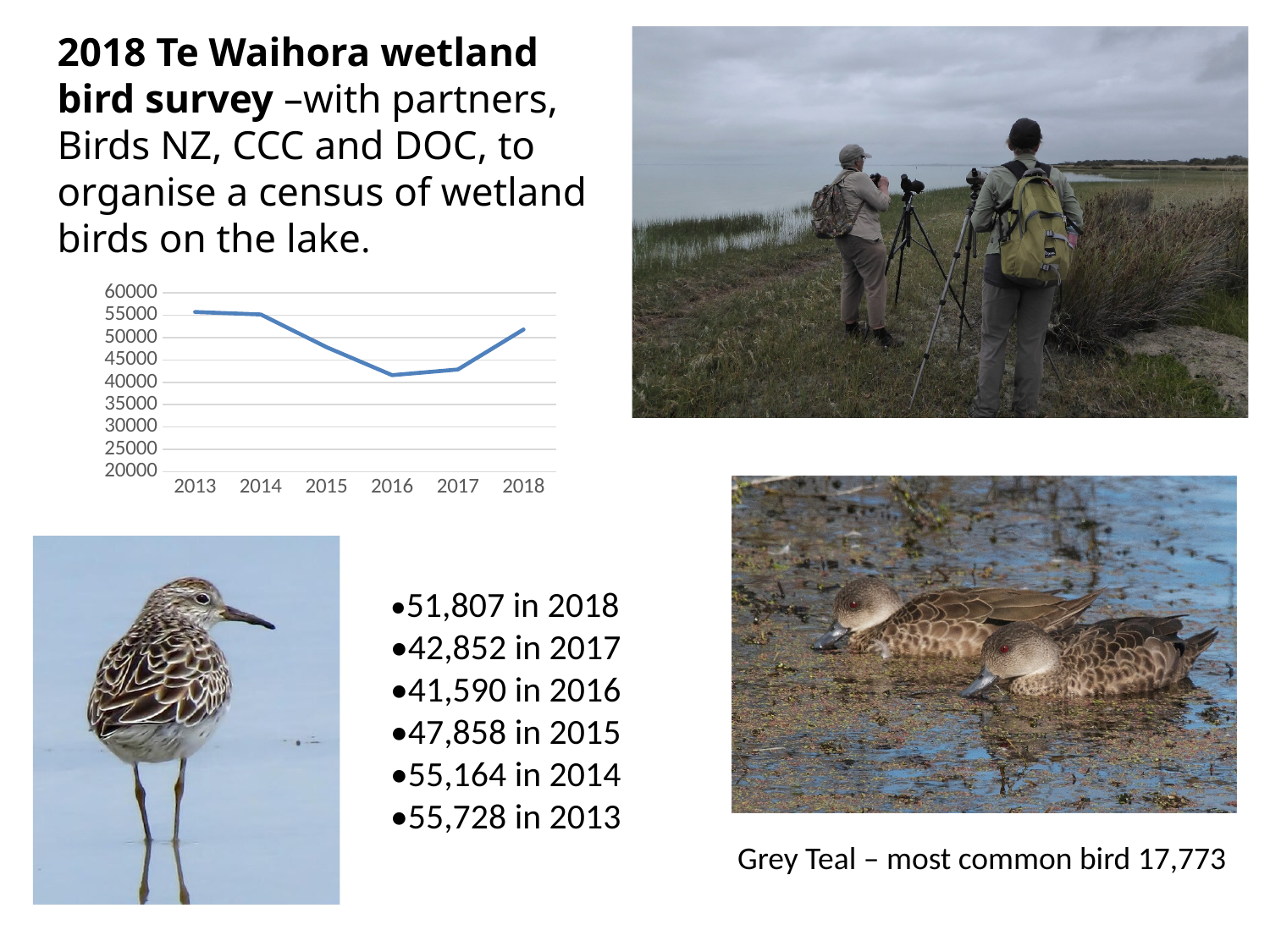
How many years are plotted on the x axis of the chart? 6 Is the value for 2016 greater or less than 45000? less What was the bird count in 2016? 41,590 Which year had the lowest bird count? 2016 What was the bird count in 2018? 51,807 Which year had a larger bird count, 2015 or 2017? 2015 What was the bird count in 2013? 55,728 What kind of chart is shown on the slide? line chart What is the difference between the 2013 and 2016 bird counts? 14,138 Does the line fall or rise from 2013 to 2016? fall What is the difference between the 2018 and 2017 bird counts? 8,955 Which year had the highest bird count? 2013